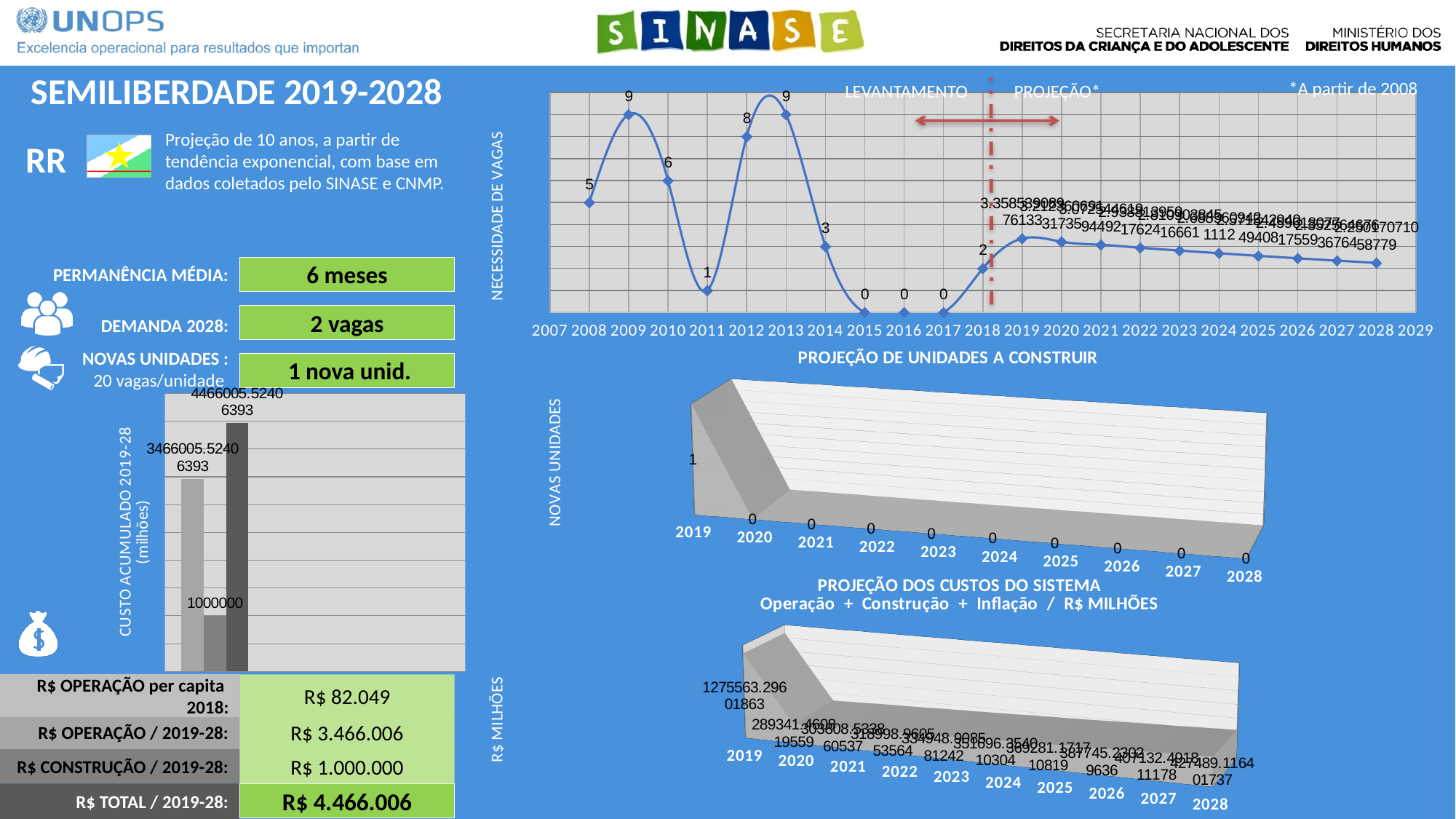
In the NECESSIDADE DE VAGAS line chart, what is the difference between the values for 2009 and 2011? 8 In the NECESSIDADE DE VAGAS line chart, what is the value for 2018? 2 In the NECESSIDADE DE VAGAS line chart, how many years between 2008 and 2018 have a value of 0? 3 In the CUSTO ACUMULADO 2019-28 chart on the left, what is the value of the middle (shortest) bar? 1000000 In the PROJEÇÃO DE UNIDADES A CONSTRUIR chart, what is the value for 2019? 1 In the NECESSIDADE DE VAGAS line chart, which year has the larger value, 2010 or 2012? 2012 In the NECESSIDADE DE VAGAS line chart, what two labels does the red dashed vertical line separate? LEVANTAMENTO and PROJEÇÃO In the NECESSIDADE DE VAGAS line chart, what is the value for 2011? 1 In the NECESSIDADE DE VAGAS line chart, what is the value for 2009? 9 In the PROJEÇÃO DE UNIDADES A CONSTRUIR chart, how many years are shown on the x axis? 10 In the NECESSIDADE DE VAGAS line chart, do the values rise or fall from 2019 to 2028? fall What kind of chart is the NECESSIDADE DE VAGAS chart at the top right? line chart